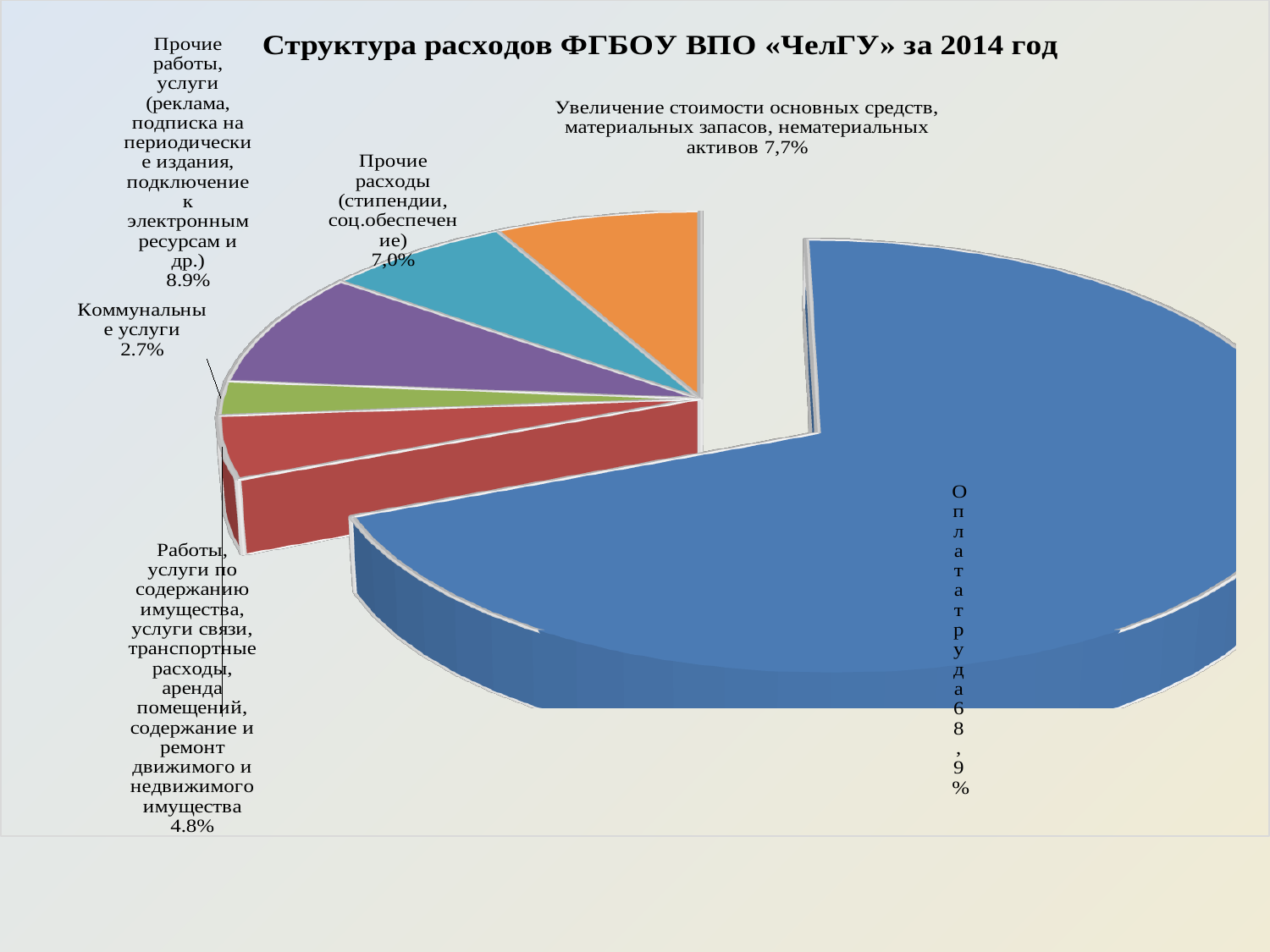
Which category has the smallest share of the pie? Коммунальные услуги What percentage is shown for Прочие расходы (стипендии, соц.обеспечение)? 7,0% What is the difference between the share for Прочие работы, услуги (8.9%) and the share for Работы, услуги по содержанию имущества... (4.8%)? 4.1% What kind of chart is shown on the slide? Pie chart What is the title of the chart? Структура расходов ФГБОУ ВПО «ЧелГУ» за 2014 год Which category has the largest share of the pie? Оплата труда Which is larger: the share for Прочие работы, услуги (реклама, подписка на периодические издания...) or the share for Прочие расходы (стипендии, соц.обеспечение)? Прочие работы, услуги (реклама, подписка на периодические издания...) What colour is the slice for Оплата труда? Blue What share of expenses is labelled for Оплата труда? 68,9% What percentage is shown for Коммунальные услуги? 2.7% How many slices does the pie chart have? 6 What percentage is shown for Увеличение стоимости основных средств, материальных запасов, нематериальных активов? 7,7%